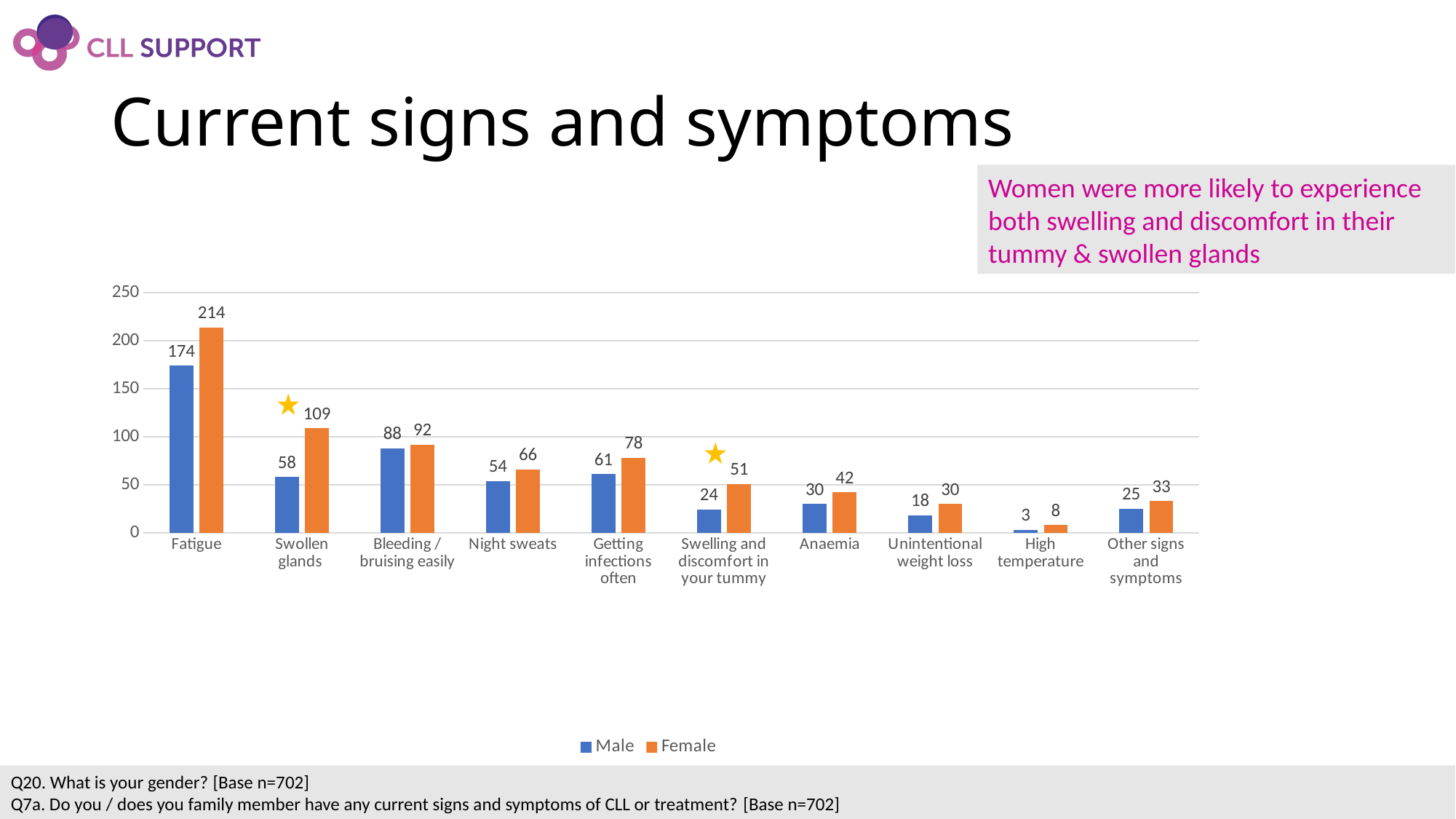
How many categories are shown on the x axis? 10 What is the Male value for Swollen glands? 58 What is the difference between the Female and Male values for Fatigue? 40 Which is larger for Anaemia, the Male value or the Female value? Female How many series does the legend list? 2 What kind of chart is shown on the slide? Bar chart What is the Female value for Fatigue? 214 What is the Female value for Swelling and discomfort in your tummy? 51 What colour are the Female bars? Orange Is the Female value for Swollen glands greater or less than 100? greater Which category has the highest Male value? Fatigue Which category has the lowest Female value? High temperature